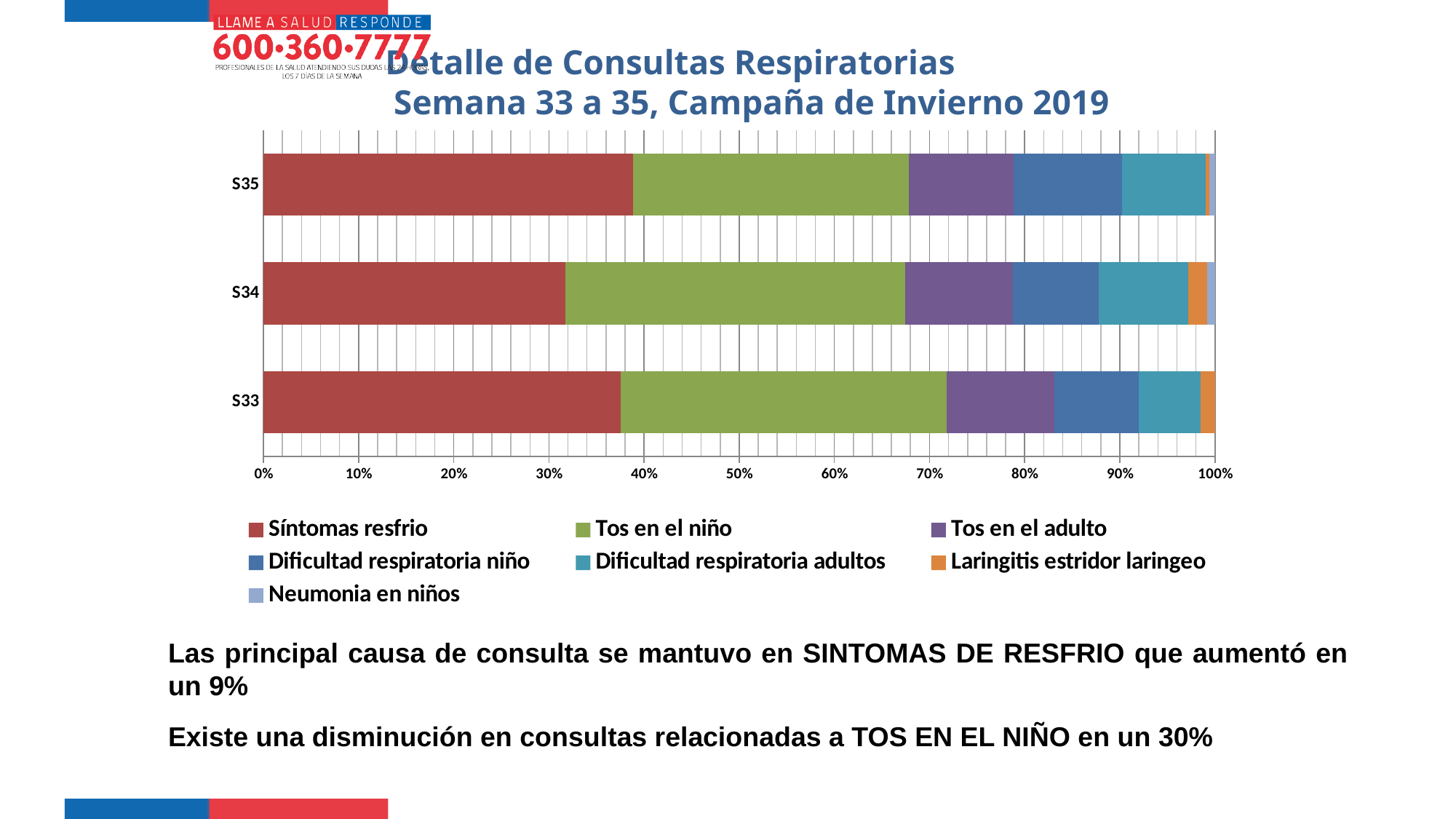
Which week has the smallest share for Síntomas resfrio? S34 What is the title of the chart? Detalle de Consultas Respiratorias Semana 33 a 35, Campaña de Invierno 2019 Which week has the largest share for Síntomas resfrio? S35 Is the share of Tos en el niño in S35 greater or less than 40%? less Is the share of Síntomas resfrio in S33 greater or less than 30%? greater What kind of chart is shown on the slide? Stacked bar chart How many series does the legend list? 7 How many weeks (categories) are plotted on the chart? 3 Which week has the smallest share for Tos en el niño? S35 Which colour represents Síntomas resfrio in the legend? Red Is the share of Síntomas resfrio in S34 greater or less than 20%? greater Which is larger, the share of Síntomas resfrio in S35 or in S34? S35